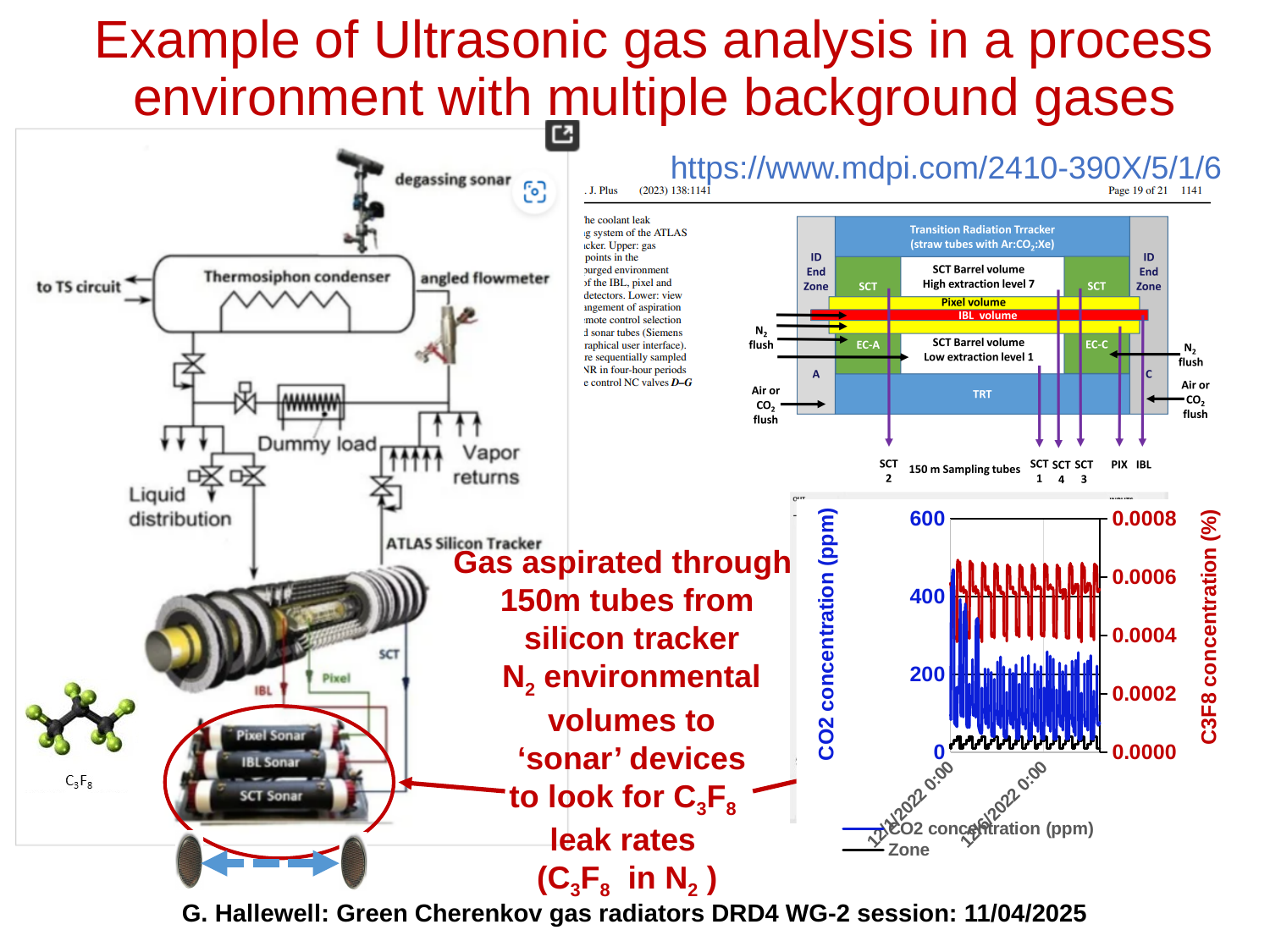
Does the blue CO2 concentration trace ever exceed 600 ppm on the chart? No What is the label of the right vertical axis of the chart? C3F8 concentration (%) What is the label of the left vertical axis of the chart? CO2 concentration (ppm) What kind of chart is shown at the bottom right of the slide? line chart What is the highest tick value shown on the right (C3F8 concentration) axis of the chart? 0.0008 Are the peaks of the red C3F8 concentration trace greater or less than 0.0008 on the right axis? less Are the peaks of the red C3F8 concentration trace greater or less than 0.0004 on the right axis? greater How many vertical axes does the chart have? 2 What is the second date label shown on the x axis of the chart? 12/6/2022 0:00 What is the first date label shown on the x axis of the chart? 12/1/2022 0:00 What is the highest tick value shown on the left (CO2 concentration) axis of the chart? 600